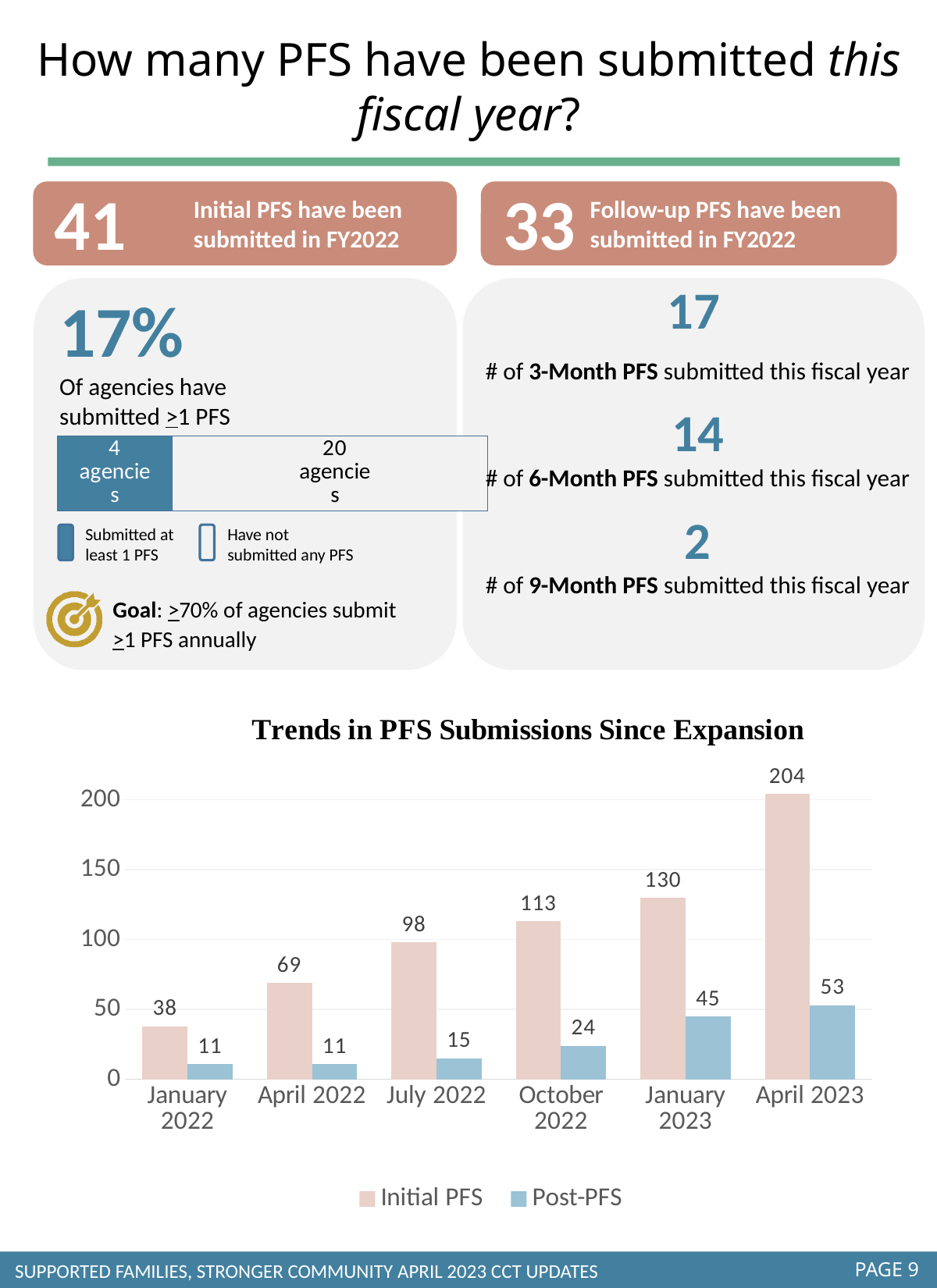
In the 'Trends in PFS Submissions Since Expansion' chart, which period has the lowest Initial PFS value? January 2022 In the 'Trends in PFS Submissions Since Expansion' chart, which is larger: the Post-PFS value for January 2023 or the Initial PFS value for January 2022? Post-PFS for January 2023 In the 'Trends in PFS Submissions Since Expansion' chart, how many series does the legend list? 2 In the 'Trends in PFS Submissions Since Expansion' chart, what is the Initial PFS value for April 2023? 204 In the 'Trends in PFS Submissions Since Expansion' chart, what is the Post-PFS value for October 2022? 24 In the 'Trends in PFS Submissions Since Expansion' chart, what is the difference between the Initial PFS and Post-PFS values for July 2022? 83 In the 'Trends in PFS Submissions Since Expansion' chart, which period has the highest Post-PFS value? April 2023 In the 'Trends in PFS Submissions Since Expansion' chart, do the Initial PFS values rise or fall from January 2022 to April 2023? Rise What kind of chart is 'Trends in PFS Submissions Since Expansion'? Bar chart In the 'Trends in PFS Submissions Since Expansion' chart, what is the difference between the Initial PFS values for April 2023 and January 2023? 74 In the 'Trends in PFS Submissions Since Expansion' chart, what are the two legend entries? Initial PFS and Post-PFS In the 'Trends in PFS Submissions Since Expansion' chart, how many time periods are shown on the x axis? 6